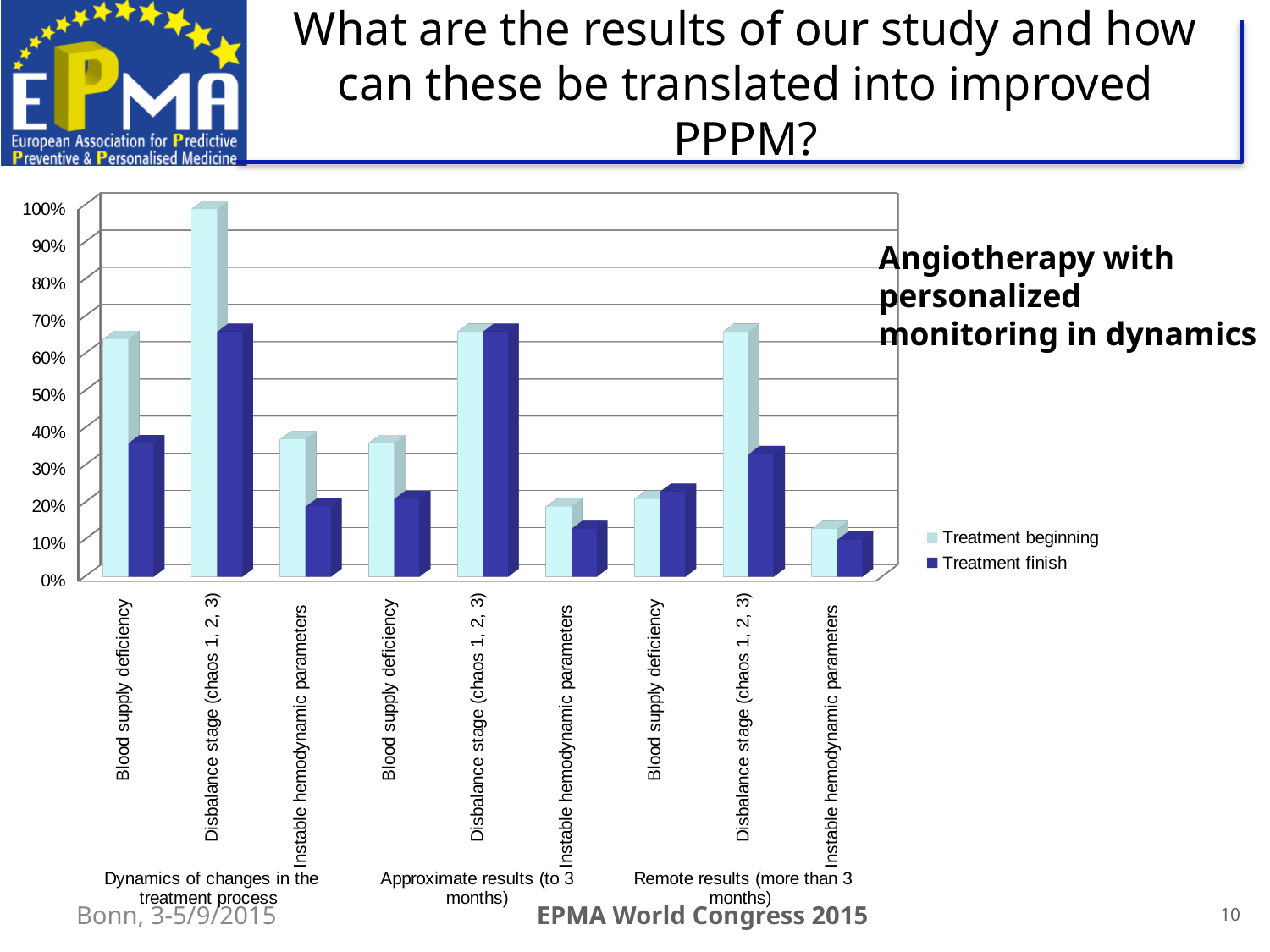
How many series does the chart legend list? 2 What text is shown as the chart's title to the right of the plot area? Angiotherapy with personalized monitoring in dynamics For Disbalance stage (chaos 1, 2, 3) in the 'Dynamics of changes in the treatment process' group, which is larger: Treatment beginning or Treatment finish? Treatment beginning Which category has the highest Treatment beginning value? Disbalance stage (chaos 1, 2, 3) in Dynamics of changes in the treatment process Is the Treatment finish value for Blood supply deficiency in the 'Dynamics of changes in the treatment process' group greater or less than 50%? less Is the Treatment beginning value for Disbalance stage (chaos 1, 2, 3) in the 'Remote results (more than 3 months)' group greater or less than 50%? greater Is the Treatment finish value for Instable hemodynamic parameters in the 'Remote results (more than 3 months)' group greater or less than 20%? less What kind of chart is shown on the slide? Bar chart What are the two series named in the chart legend? Treatment beginning and Treatment finish How many categories (bar groups) are plotted along the x axis of the chart? 9